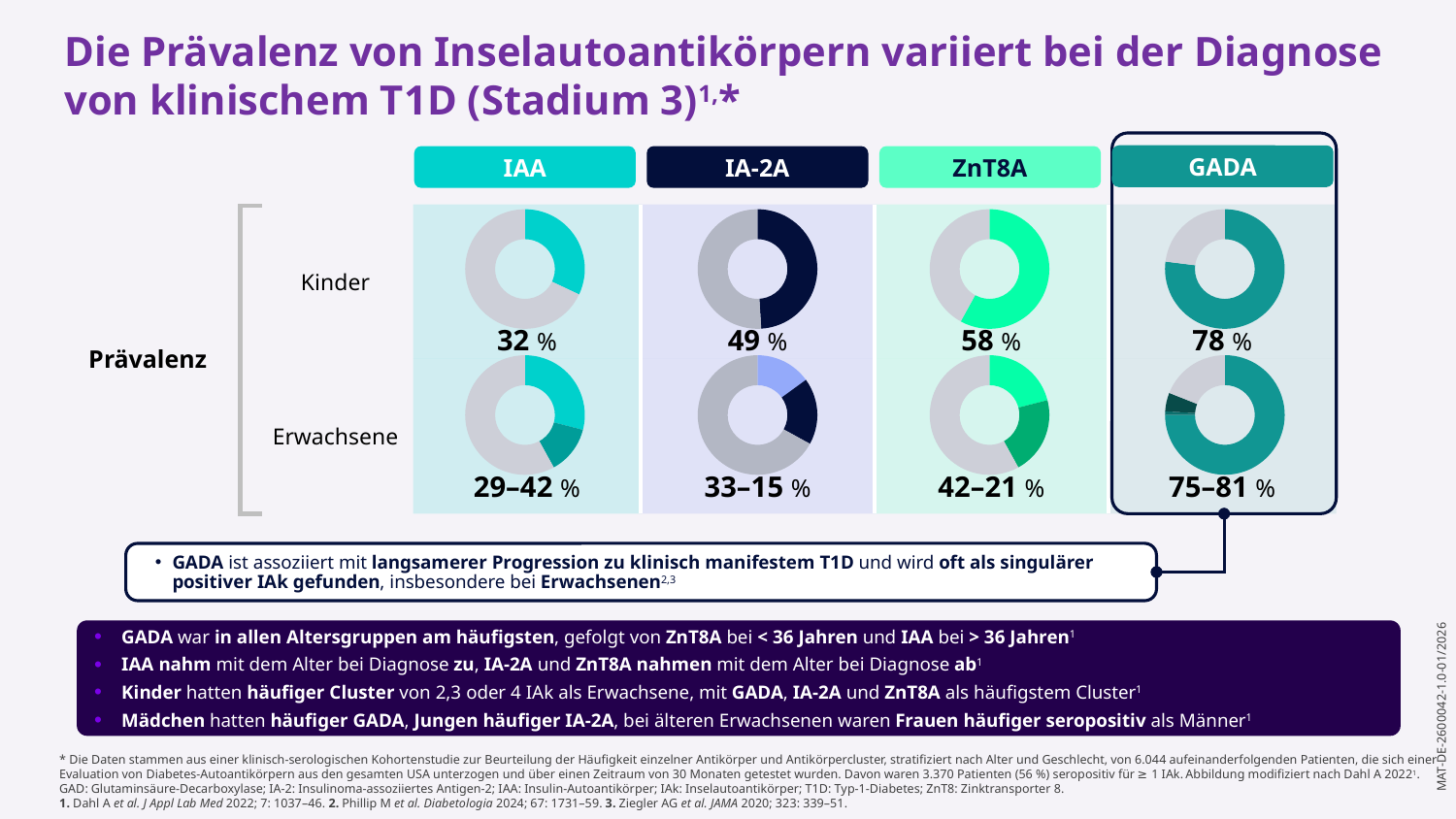
Which autoantibody column is highlighted with a dark outline box? GADA What is the difference between the GADA and IAA prevalence among Kinder? 46 % Among Kinder, which has the higher prevalence: ZnT8A or IA-2A? ZnT8A What prevalence range is shown for IA-2A among Erwachsene (adults)? 33–15 % Which autoantibody has the highest prevalence among Kinder? GADA What is the prevalence of IAA among Kinder (children)? 32 % How many autoantibodies are shown in the chart? 4 What kind of chart is used to show the prevalence values? Donut (pie) chart What prevalence range is shown for GADA among Erwachsene? 75–81 % What is the prevalence of GADA among Kinder? 78 % Which autoantibody has the lowest prevalence among Kinder? IAA What prevalence range is shown for ZnT8A among Erwachsene? 42–21 %